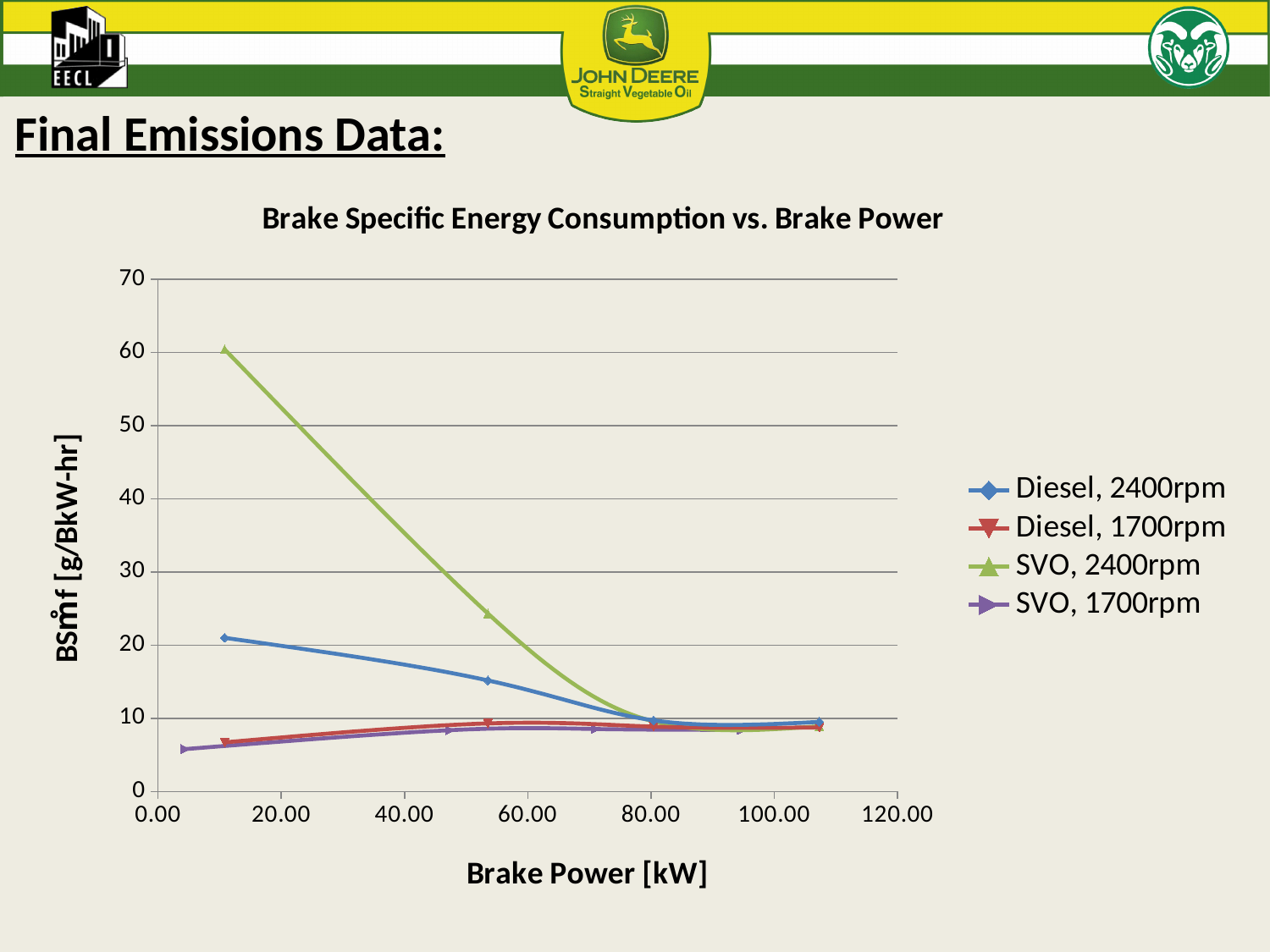
At the lowest brake power plotted, which series has the larger BSmf value: Diesel, 2400rpm or Diesel, 1700rpm? Diesel, 2400rpm Is the first (lowest brake power) value of the SVO, 2400rpm series greater or less than 50? greater What kind of chart is shown on the slide? line chart What is the title of the chart? Brake Specific Energy Consumption vs. Brake Power Does the SVO, 2400rpm series rise or fall as brake power increases? fall Does the Diesel, 2400rpm series rise or fall as brake power increases? fall Is the first (lowest brake power) value of the SVO, 1700rpm series greater or less than 10? less What is the label of the x axis? Brake Power [kW] Is the first (lowest brake power) value of the Diesel, 2400rpm series greater or less than 30? less Which series reaches the highest BSmf value on the chart? SVO, 2400rpm How many series does the legend list? 4 At a brake power of about 53 kW, which series has the larger BSmf value: SVO, 2400rpm or Diesel, 2400rpm? SVO, 2400rpm